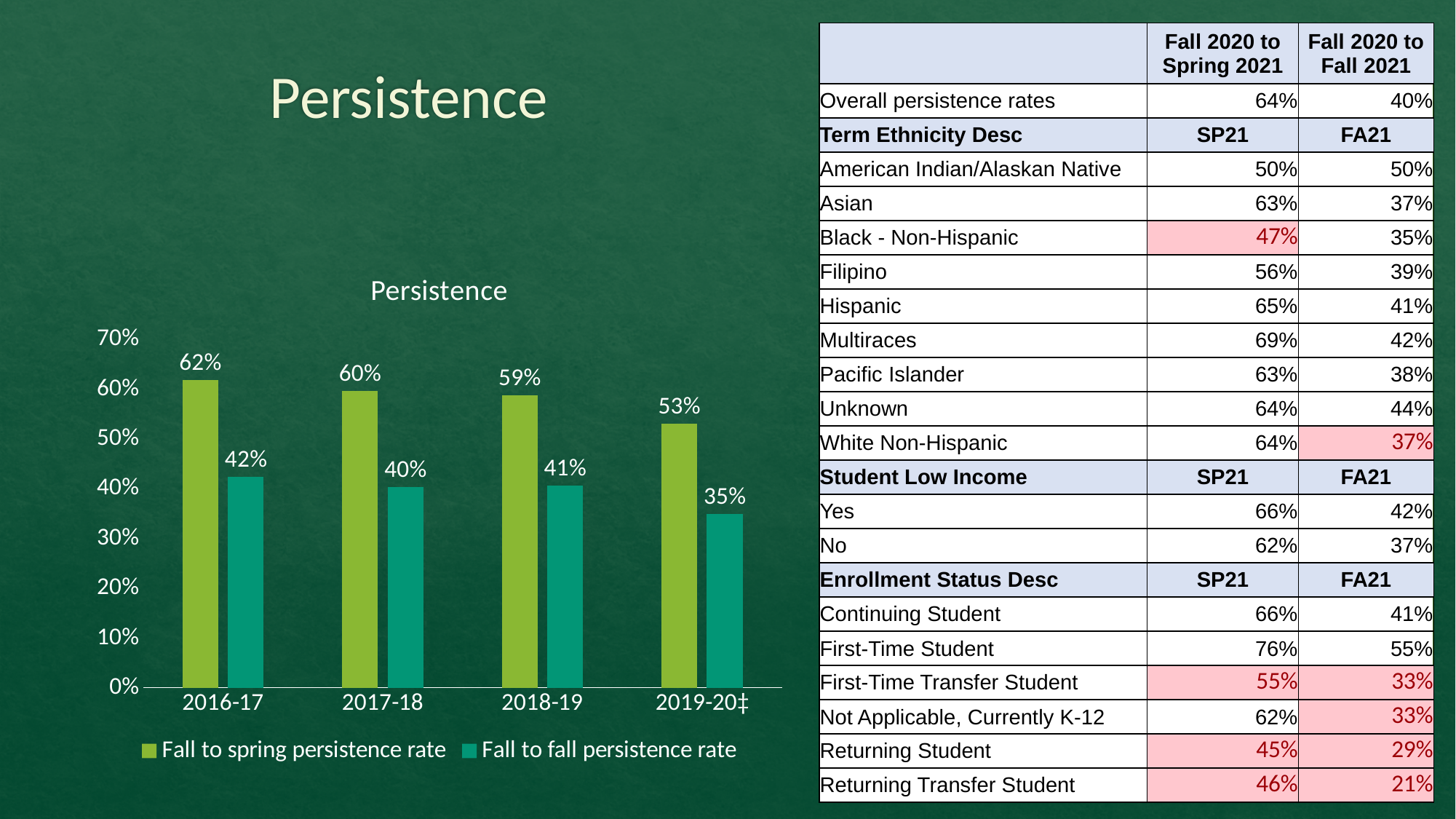
What kind of chart is shown on the slide? Bar chart Which year has the highest fall to spring persistence rate? 2016-17 What is the title of the chart? Persistence Which year has the lowest fall to fall persistence rate? 2019-20‡ What is the fall to fall persistence rate for 2019-20‡? 35% What is the difference between the fall to spring and fall to fall persistence rates in 2017-18? 20% What is the fall to fall persistence rate for 2018-19? 41% What is the fall to spring persistence rate for 2016-17? 62% Which is larger, the fall to fall persistence rate for 2016-17 or for 2019-20‡? 2016-17 How many series does the chart legend list? 2 Does the fall to spring persistence rate rise or fall from 2016-17 to 2019-20‡? Fall How many years are shown on the x axis of the chart? 4